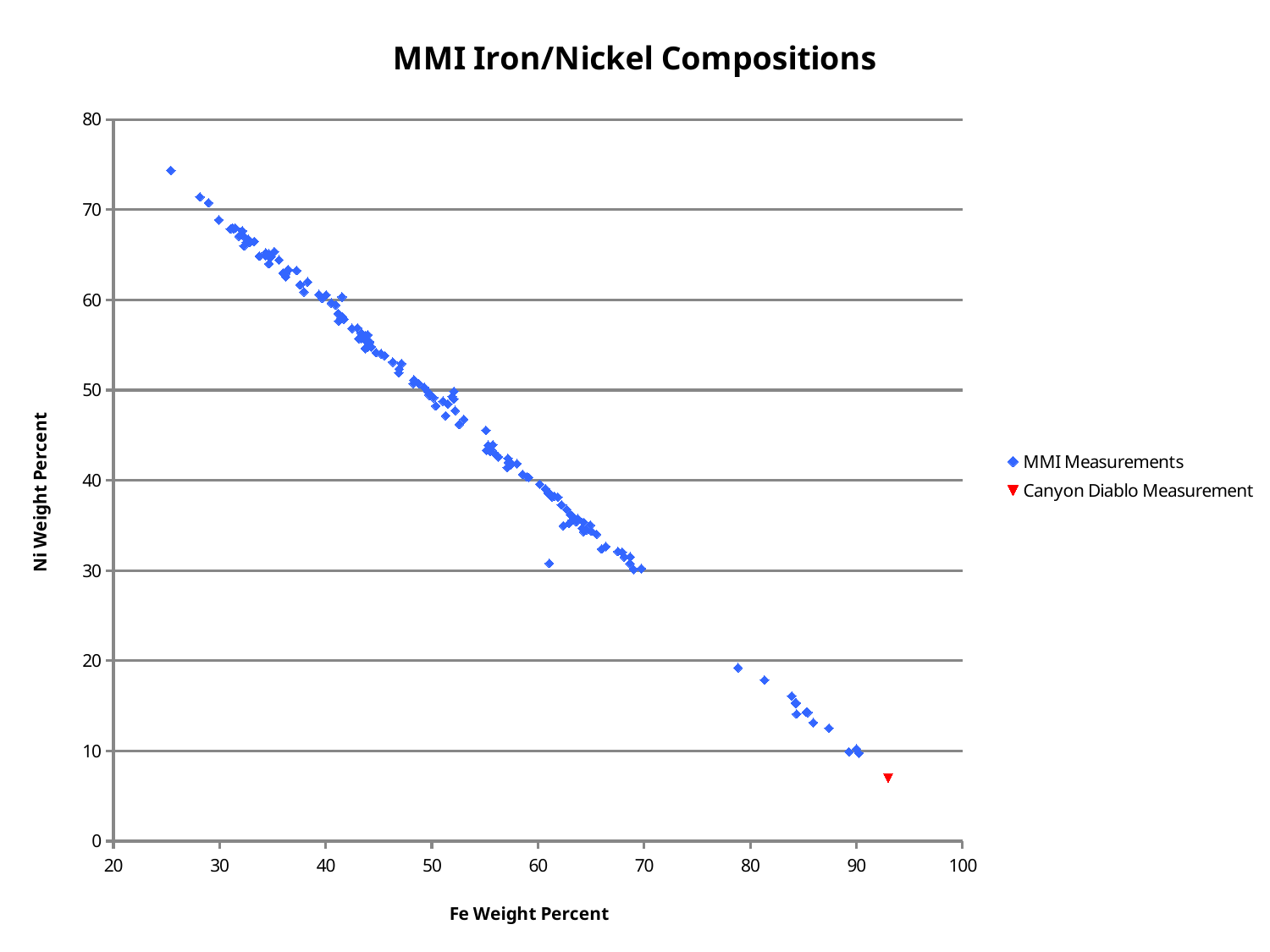
Is the Fe Weight Percent value for the Canyon Diablo Measurement greater or less than 90? greater Is the Ni Weight Percent value for the Canyon Diablo Measurement greater or less than 10? less Is the lowest Fe Weight Percent value among the MMI Measurements greater or less than 30? less How many series does the legend list? 2 What is the label of the x axis? Fe Weight Percent How many points does the Canyon Diablo Measurement series have? 1 What is the title of the chart? MMI Iron/Nickel Compositions What kind of chart is shown on the slide? scatter chart Which series has the point with the lowest Ni Weight Percent, MMI Measurements or Canyon Diablo Measurement? Canyon Diablo Measurement As Fe Weight Percent increases along the x axis, do the Ni Weight Percent values of the MMI Measurements rise or fall? fall